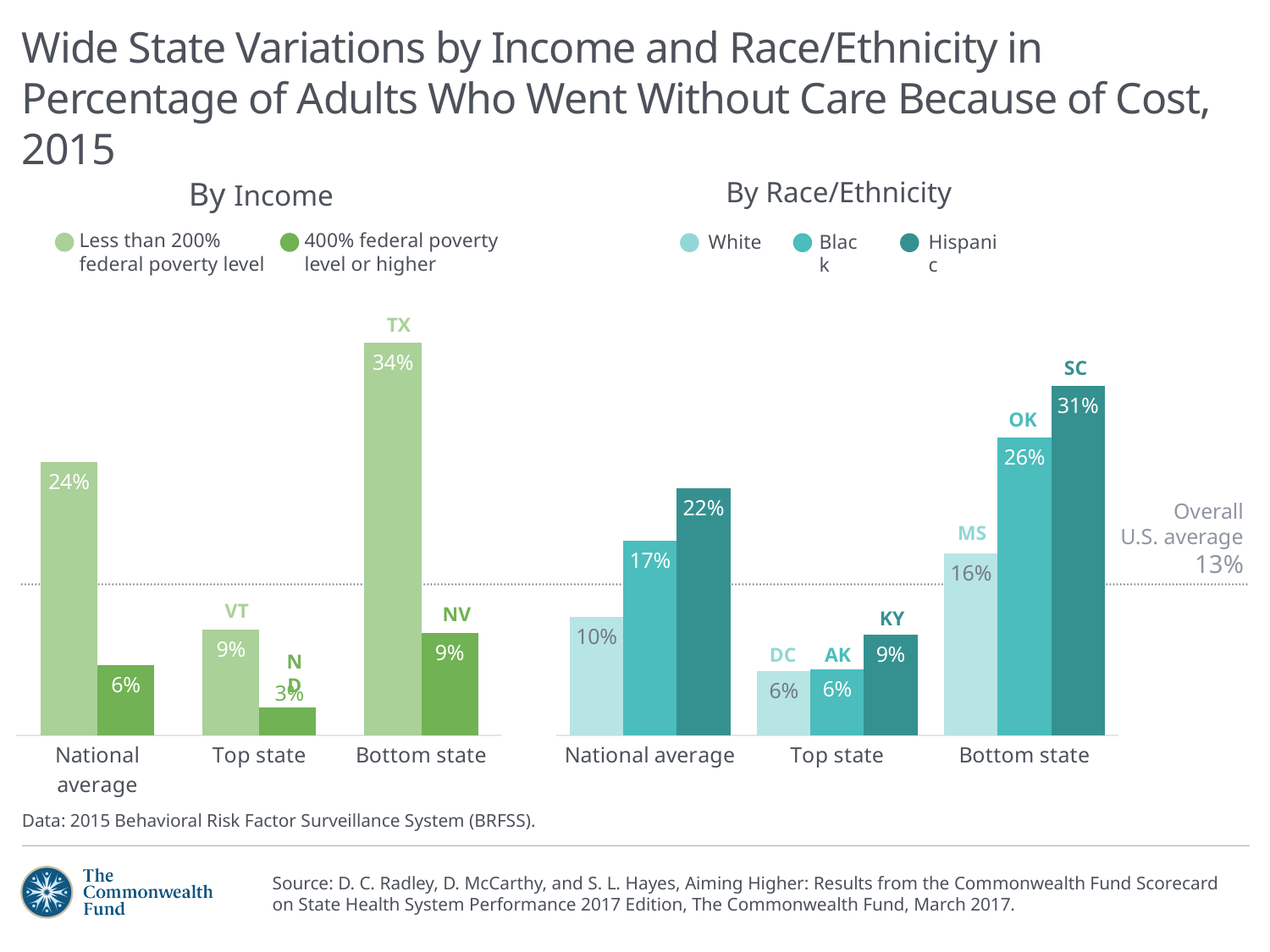
In the By Race/Ethnicity chart, what is the bottom state value for Black adults? 26% In the By Race/Ethnicity chart, how many series does the legend list? 3 What kind of chart is the By Income chart? Bar chart In the By Race/Ethnicity chart, what is the difference between the bottom state value for Hispanic adults and the bottom state value for White adults? 15% In the By Race/Ethnicity chart, what is the national average for Hispanic adults? 22% In the By Income chart, what is the bottom state value for adults with less than 200% federal poverty level? 34% In the By Race/Ethnicity chart, which series has the highest bottom state value? Hispanic What overall U.S. average is marked by the dotted line across the charts? 13% In the By Income chart, what is the difference between the bottom state and top state values for the less than 200% federal poverty level series? 25% In the By Income chart, which state is labeled as the top state for the 400% federal poverty level or higher series? ND In the By Income chart, what is the national average for adults with less than 200% federal poverty level? 24% In the By Race/Ethnicity chart, which is larger: the national average for White adults or for Black adults? Black